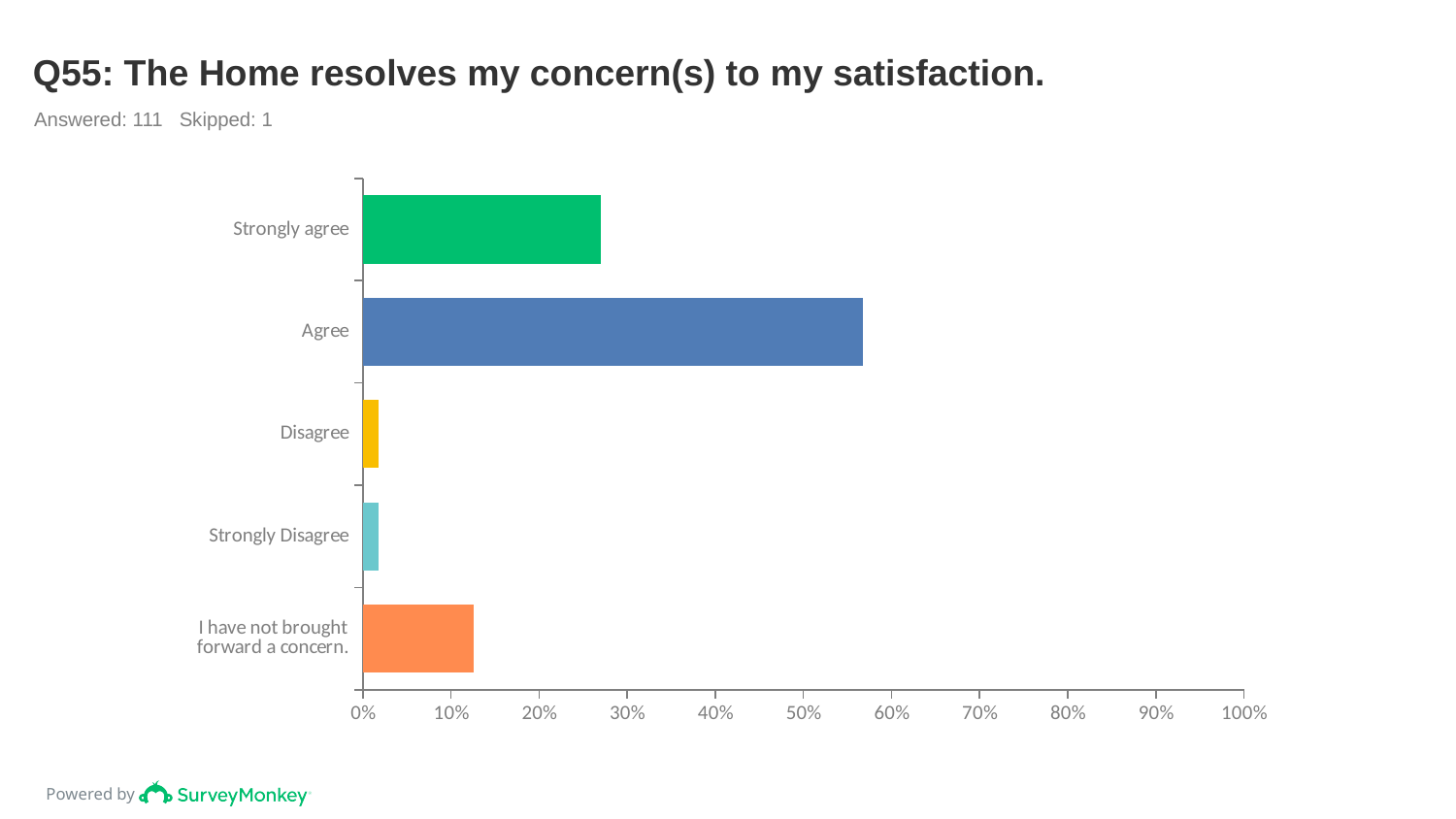
Which is larger, the value for Strongly agree or the value for 'I have not brought forward a concern.'? Strongly agree Which response category has the highest value? Agree Is the value for Disagree greater or less than 10%? less Is the value for Strongly agree greater or less than 30%? less Is the value for Agree greater or less than 50%? greater Which is larger, the value for Strongly agree or the value for Agree? Agree How many response categories are shown on the chart? 5 What kind of chart is shown on the slide? bar chart How many respondents answered this question according to the slide? 111 What is the title of the chart? Q55: The Home resolves my concern(s) to my satisfaction.